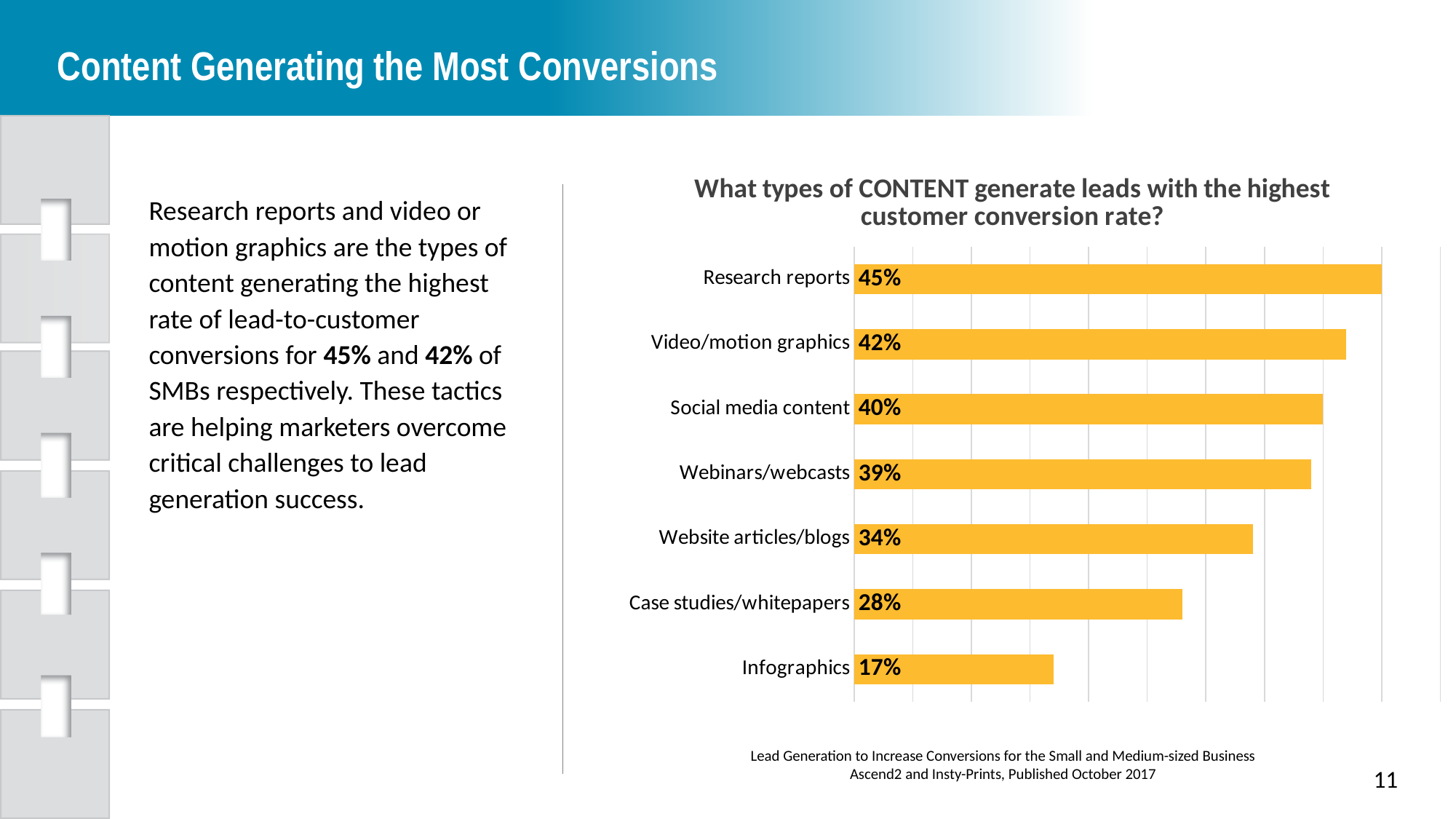
Which has a larger value, Case studies/whitepapers or Website articles/blogs? Website articles/blogs What value does the chart show for Webinars/webcasts? 39% What is the difference between the values for Social media content and Website articles/blogs? 6% What percentage is shown for Case studies/whitepapers? 28% Which has a larger value, Video/motion graphics or Webinars/webcasts? Video/motion graphics Which content type has the lowest value in the chart? Infographics What kind of chart is shown on the slide? Bar chart What percentage is shown for Research reports? 45% Which content type has the highest value in the chart? Research reports What is the difference between the values for Research reports and Infographics? 28% How many content types are shown in the chart? 7 What is the title of the chart? What types of CONTENT generate leads with the highest customer conversion rate?